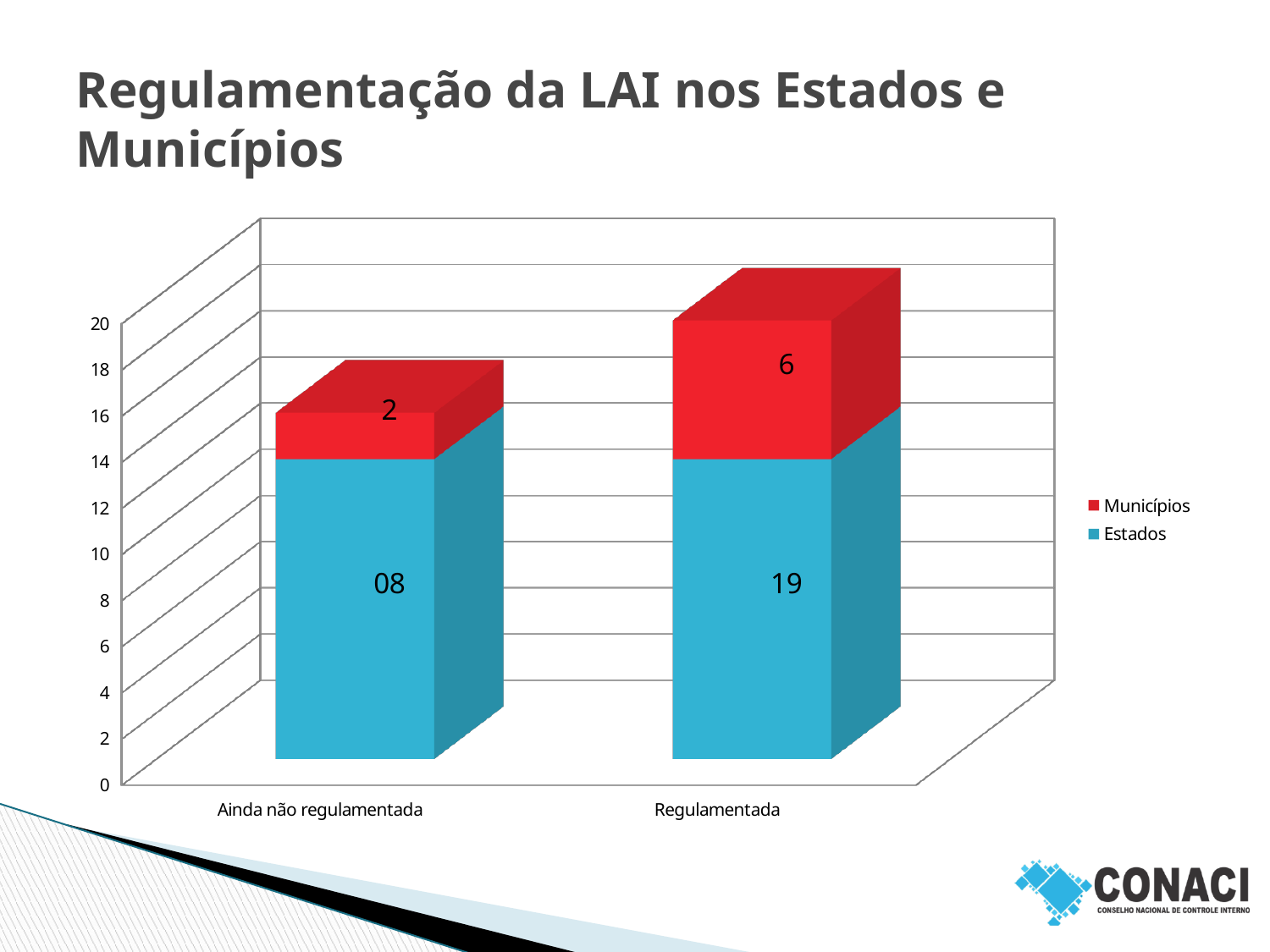
What is the total of the stacked bar for 'Regulamentada'? 25 How many categories are shown on the x axis? 2 What is the value for Estados in the 'Ainda não regulamentada' category? 08 What kind of chart is shown on the slide? Stacked bar chart What is the value for Estados in the 'Regulamentada' category? 19 What is the value for Municípios in the 'Ainda não regulamentada' category? 2 What is the difference between the Municípios values for 'Regulamentada' and 'Ainda não regulamentada'? 4 How many series does the legend list? 2 What is the difference between the Estados values for 'Regulamentada' and 'Ainda não regulamentada'? 11 Which series is shown in red in the legend? Municípios Which category has the higher Estados value, 'Regulamentada' or 'Ainda não regulamentada'? Regulamentada What is the value for Municípios in the 'Regulamentada' category? 6